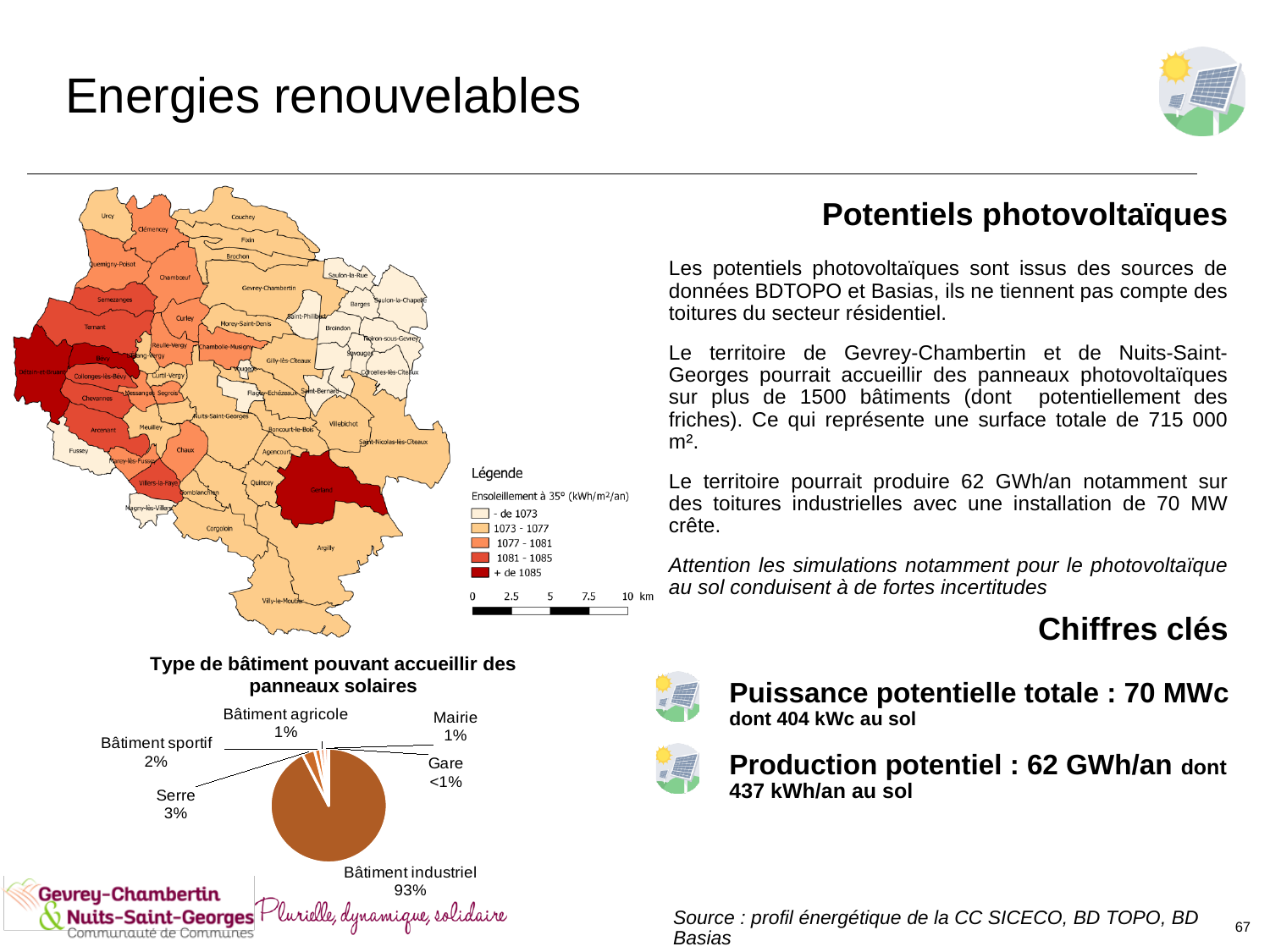
In the pie chart, which is larger: Serre or Bâtiment sportif? Serre How many categories does the pie chart show? 6 What kind of chart is "Type de bâtiment pouvant accueillir des panneaux solaires"? pie chart In the pie chart, what share is shown for Gare? <1% In the pie chart, what share is shown for Bâtiment industriel? 93% Which category has the largest slice in the pie chart? Bâtiment industriel What is the title of the pie chart? Type de bâtiment pouvant accueillir des panneaux solaires In the pie chart, what share is shown for Bâtiment agricole? 1% Which category has the smallest slice in the pie chart? Gare In the pie chart, what is the difference in percentage points between Bâtiment industriel and Serre? 90 In the pie chart, what share is shown for Serre? 3% In the pie chart, what share is shown for Bâtiment sportif? 2%